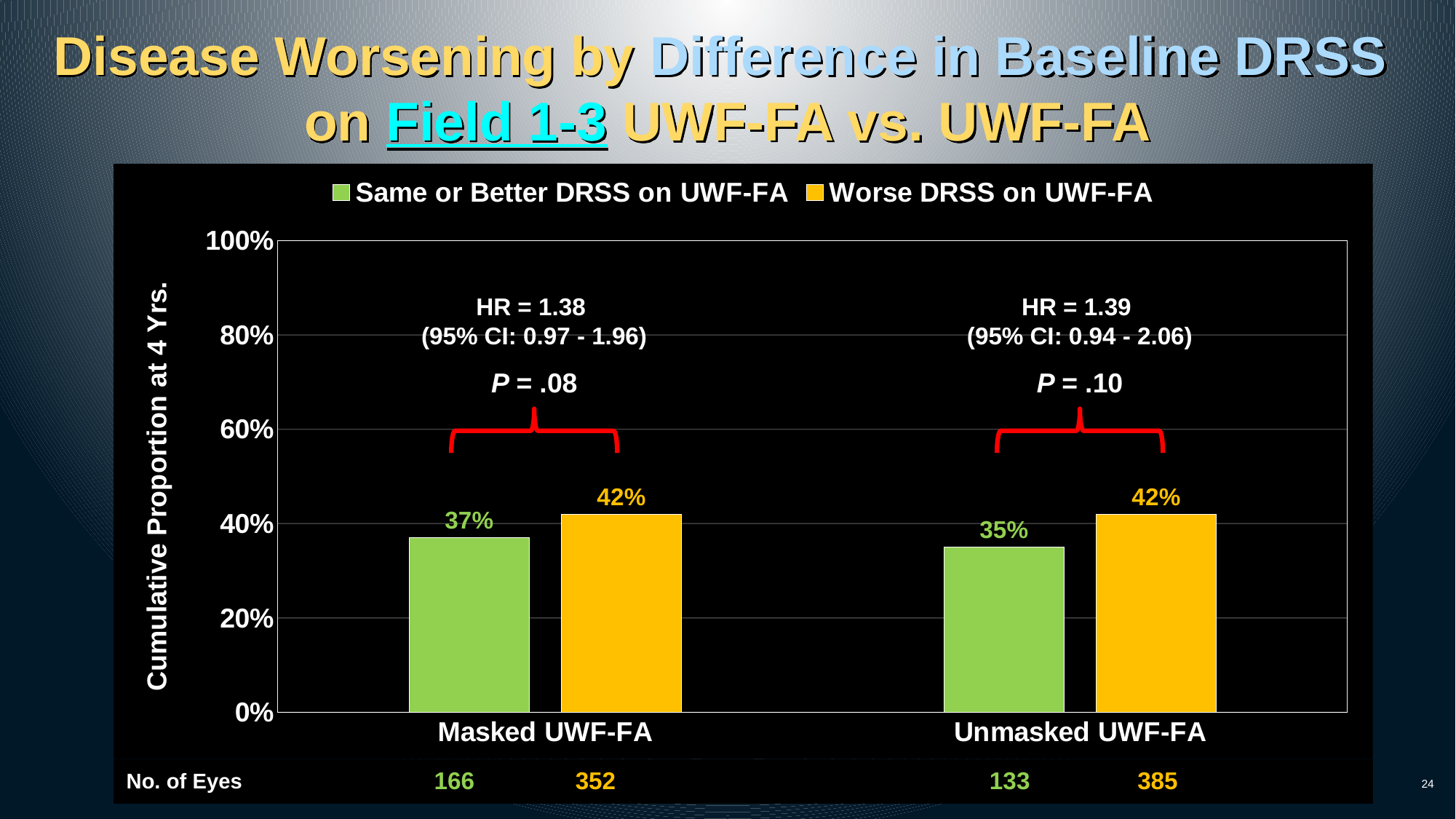
What is the cumulative proportion at 4 years for Worse DRSS on UWF-FA in the Unmasked UWF-FA group? 42% Which bar has the lowest value on the chart? Same or Better DRSS on UWF-FA, Unmasked UWF-FA (35%) What is the cumulative proportion at 4 years for Same or Better DRSS on UWF-FA in the Masked UWF-FA group? 37% In the Masked UWF-FA group, which is larger: Same or Better DRSS on UWF-FA or Worse DRSS on UWF-FA? Worse DRSS on UWF-FA What is the difference between the Worse DRSS and Same or Better DRSS values in the Masked UWF-FA group? 5% Is the value for Same or Better DRSS on UWF-FA in the Masked UWF-FA group greater or less than 40%? less What is the label of the y axis? Cumulative Proportion at 4 Yrs. How many series does the legend list? 2 What is the difference between the Worse DRSS and Same or Better DRSS values in the Unmasked UWF-FA group? 7% What is the value for Same or Better DRSS on UWF-FA in the Unmasked UWF-FA group? 35% What kind of chart is shown on the slide? Bar chart How many categories are shown on the x axis? 2